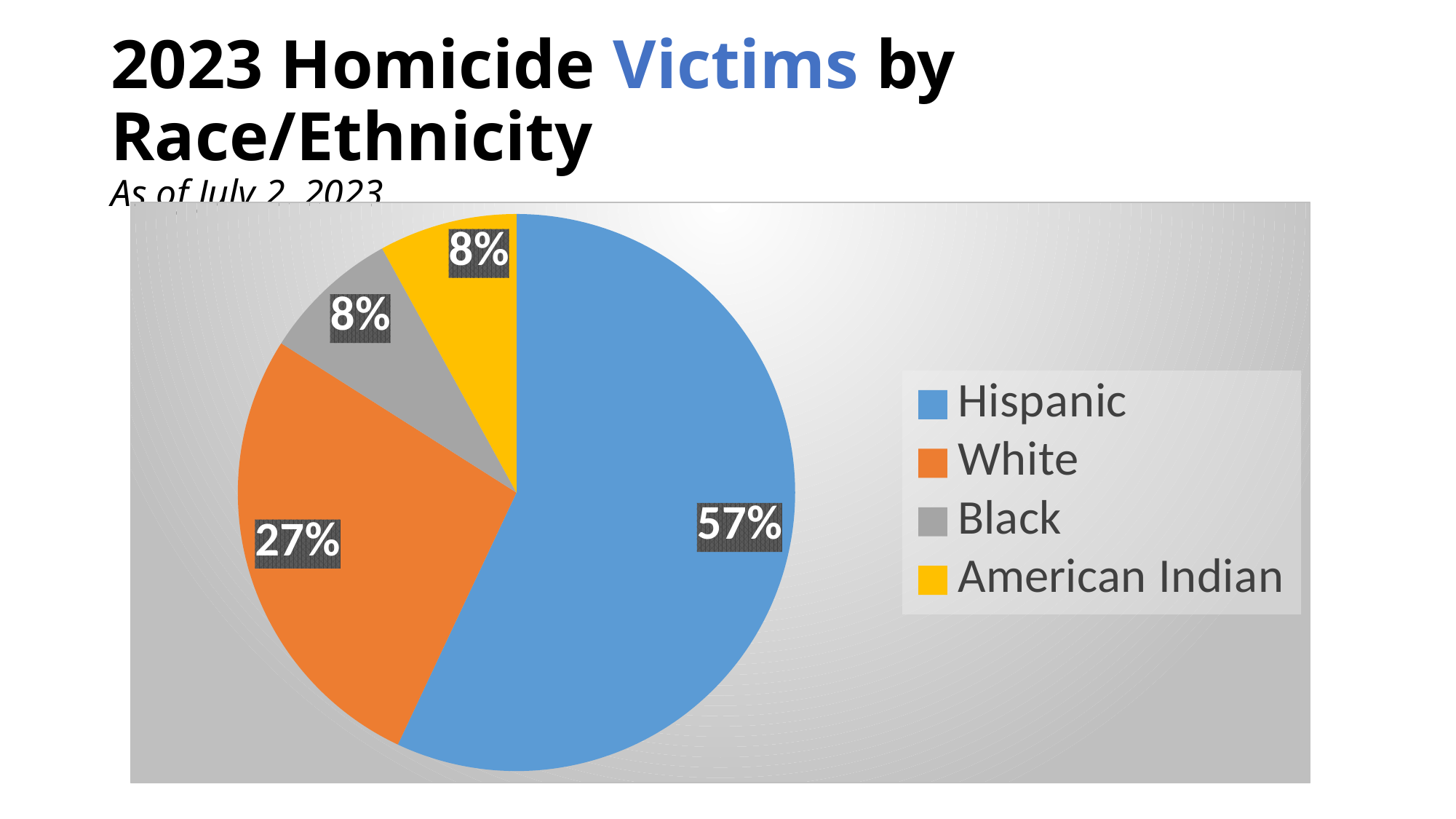
Which share is larger, White or Black? White What colour represents American Indian in the pie chart? yellow How many race/ethnicity categories does the pie chart show? 4 Which race/ethnicity has the largest share of 2023 homicide victims? Hispanic What is the title of the chart on the slide? 2023 Homicide Victims by Race/Ethnicity What share of 2023 homicide victims were Black? 8% What share of 2023 homicide victims were Hispanic? 57% What is the difference in percentage points between the Hispanic and White shares? 30 What share of 2023 homicide victims were American Indian? 8% How many entries does the legend list? 4 What kind of chart is shown on the slide? pie chart